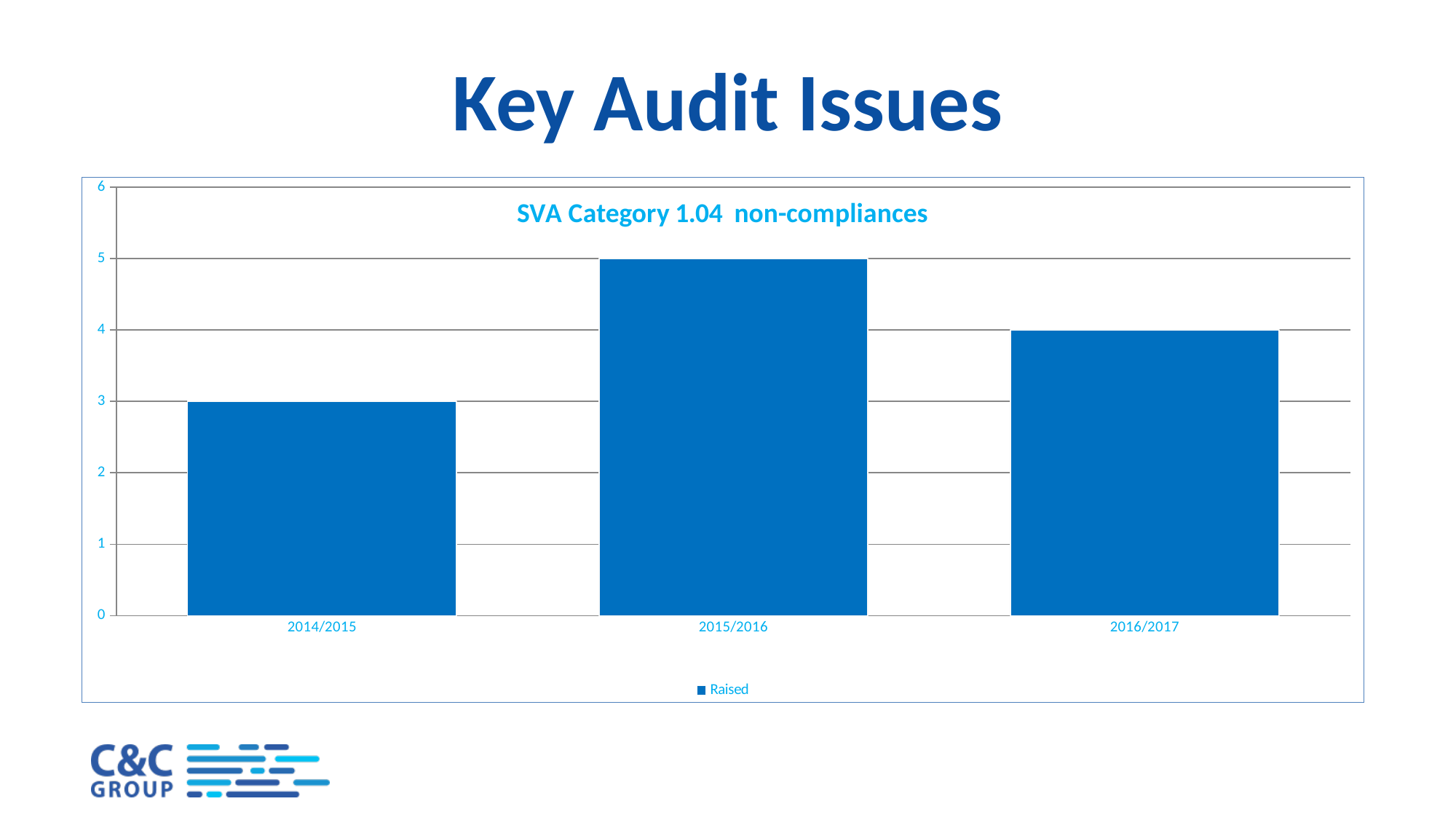
What is the value for 2014/2015? 3 What is the title of the chart? SVA Category 1.04 non-compliances Which is larger, the value for 2016/2017 or the value for 2014/2015? 2016/2017 How many categories are shown on the x axis? 3 What is the difference between the values for 2015/2016 and 2014/2015? 2 Is the value for 2015/2016 greater or less than 4? greater What is the value for 2015/2016? 5 What kind of chart is shown on the slide? bar chart Which year has the highest number of non-compliances raised? 2015/2016 What is the value for 2016/2017? 4 How many series does the legend list? 1 Which year has the lowest number of non-compliances raised? 2014/2015